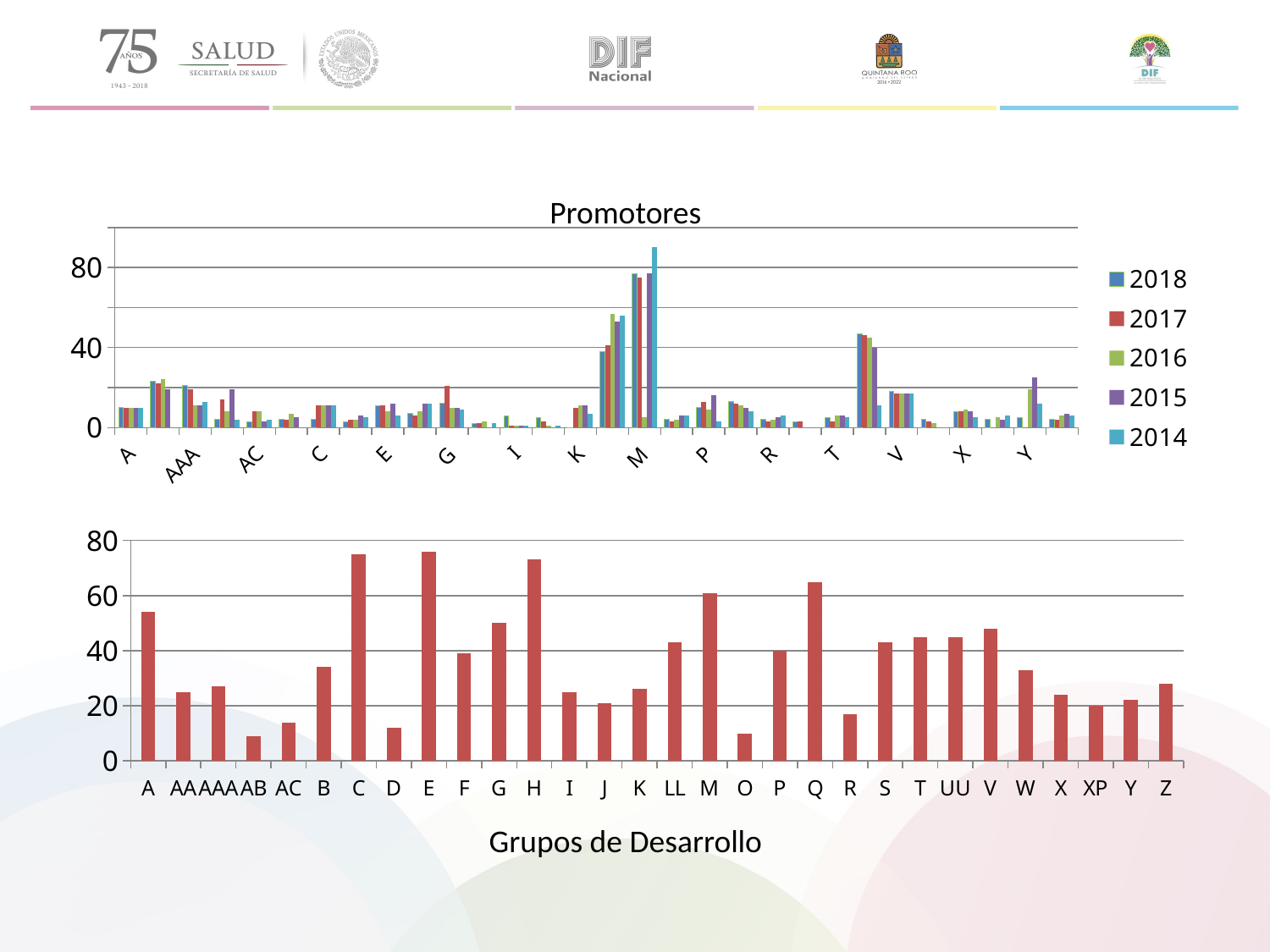
In the 'Grupos de Desarrollo' chart, which is larger, the value for C or the value for D? C In the 'Grupos de Desarrollo' chart, is the value for C greater or less than 60? greater In the 'Grupos de Desarrollo' chart, is the value for Q greater or less than 60? greater In the 'Promotores' chart, is the 2014 value for M greater or less than 80? greater In the 'Grupos de Desarrollo' chart, which is larger, the value for H or the value for I? H How many categories are shown on the x axis of the 'Grupos de Desarrollo' chart? 30 Which years are listed in the legend of the 'Promotores' chart? 2018, 2017, 2016, 2015, 2014 What kind of chart is the bottom chart titled 'Grupos de Desarrollo'? bar chart In the 'Promotores' chart, which category has the tallest bar overall? M How many series does the legend of the 'Promotores' chart list? 5